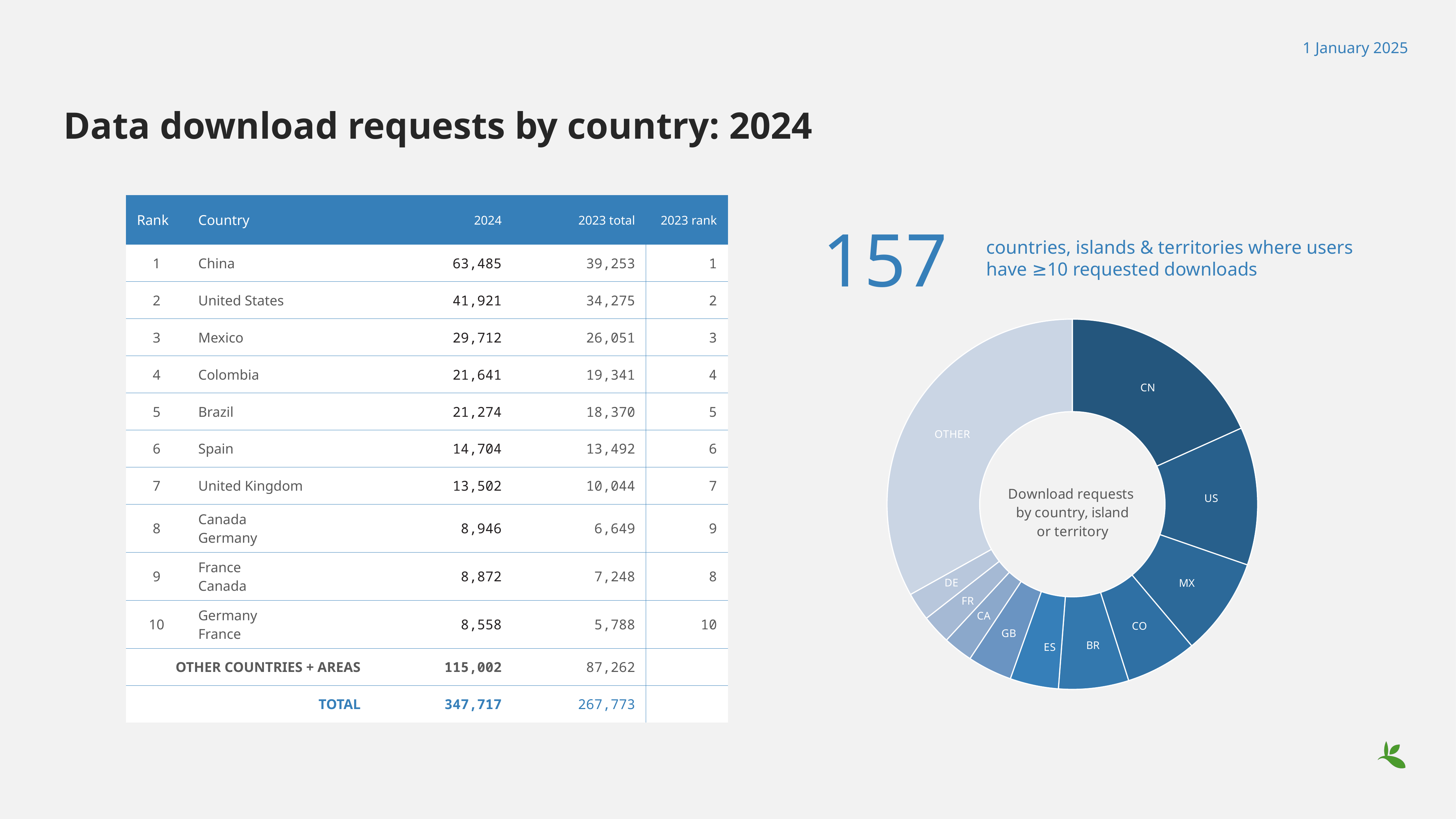
What kind of chart is shown on the right of the slide? Donut chart Which slice of the donut chart is the smallest? DE What is the text printed in the centre of the donut chart? Download requests by country, island or territory What is the total of 2024 download requests shown in the table? 347,717 What is the difference between the 2024 values for China and the United States shown in the table? 21,564 Which slice of the donut chart is larger, ES or GB? ES Which slice of the donut chart is larger, US or MX? US How many slices does the donut chart have? 11 Which slice of the donut chart is the largest? OTHER According to the table, what is the 2024 value for the CN slice of the donut chart (China)? 63,485 According to the table, what is the 2024 value for the OTHER slice of the donut chart? 115,002 Which country slice of the donut chart is the largest? CN